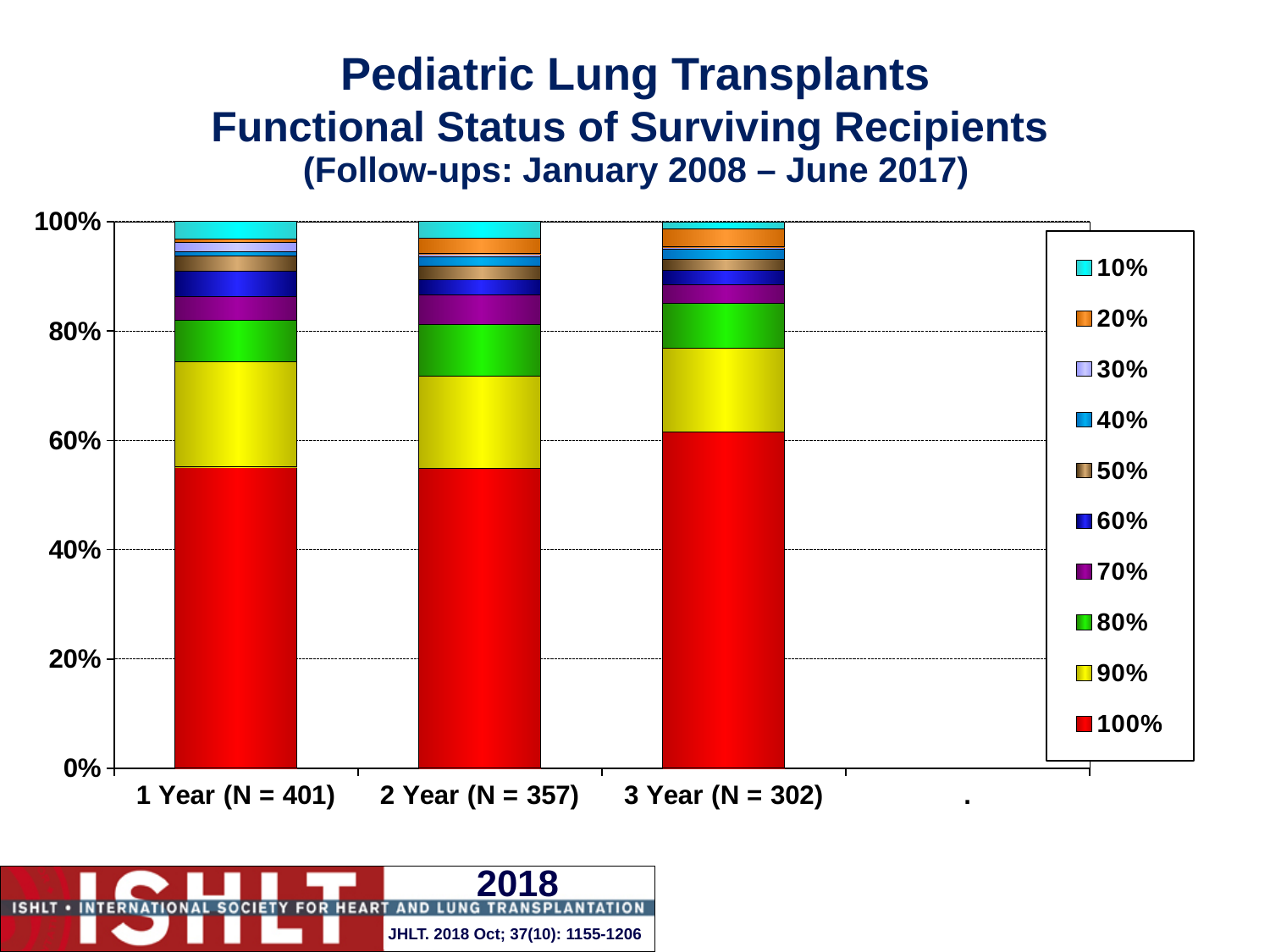
How many bars (follow-up time points) are plotted in the chart? 3 Is the 100% functional status segment of the 1 Year bar greater or less than 60%? less What is the sample size (N) shown for the 3 Year bar? 302 What kind of chart is shown on the slide? stacked bar chart Which series forms the bottom segment of each stacked bar? 100% What is the sample size (N) shown for the 1 Year bar? 401 What does each stacked bar total on the y axis? 100% How many series does the legend list? 10 Is the 100% functional status segment larger in the 1 Year bar or the 3 Year bar? 3 Year bar Is the 100% functional status segment of the 2 Year bar greater or less than 60%? less Which bar has the largest 100% functional status segment? 3 Year (N = 302)